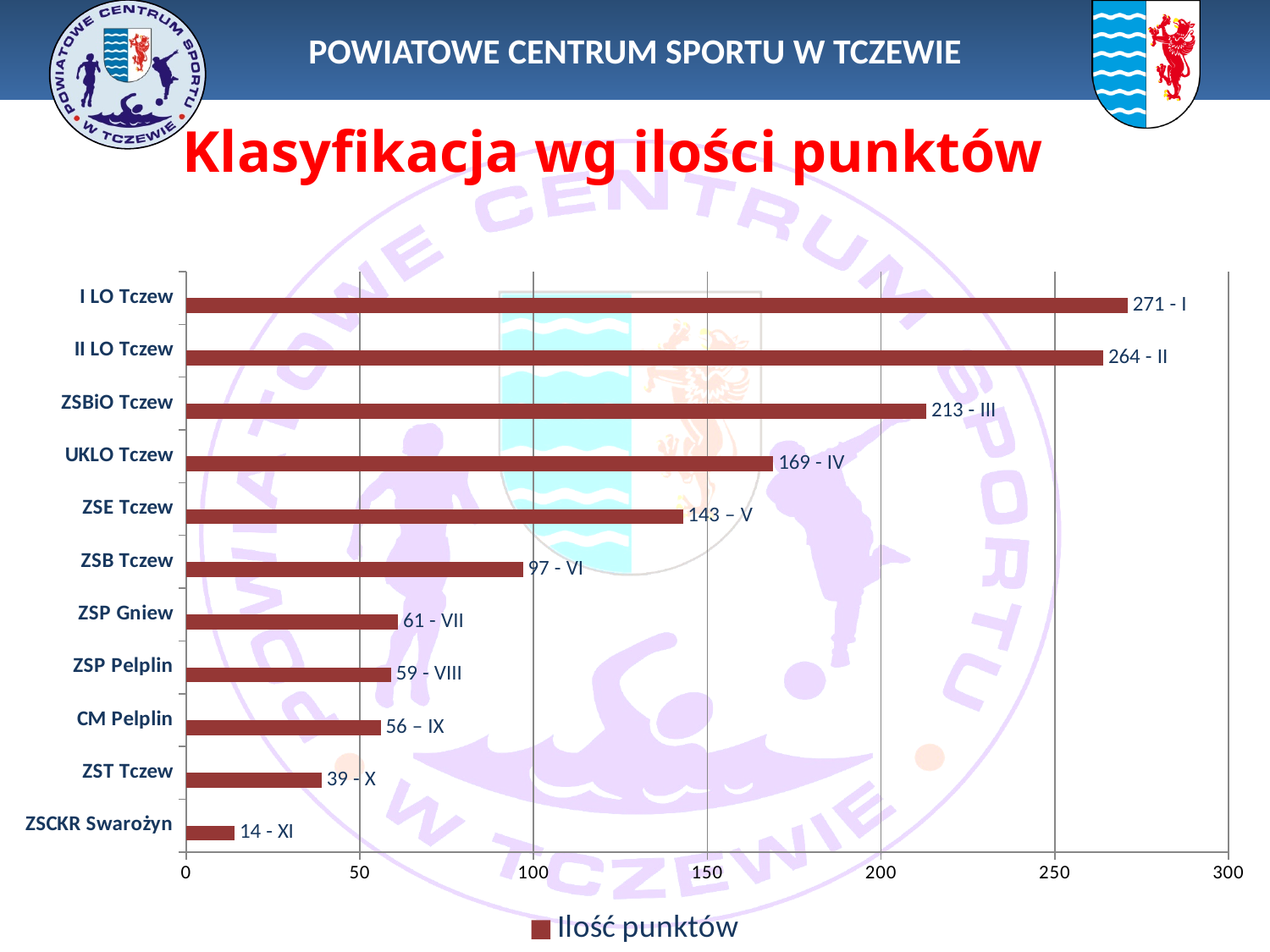
Which school has the lowest number of points? ZSCKR Swarożyn How many points does I LO Tczew have according to the chart? 271 Which school has the highest number of points? I LO Tczew How many schools are listed on the chart? 11 How many series does the legend list? 1 What is the legend entry shown below the chart? Ilość punktów How many points does ZSCKR Swarożyn have? 14 What data label is printed next to the bar for ZSE Tczew? 143 – V Which has more points, ZSB Tczew or ZSP Gniew? ZSB Tczew What is the difference in points between I LO Tczew and II LO Tczew? 7 What is the difference in points between ZSBiO Tczew and UKLO Tczew? 44 What type of chart is shown on the slide? bar chart